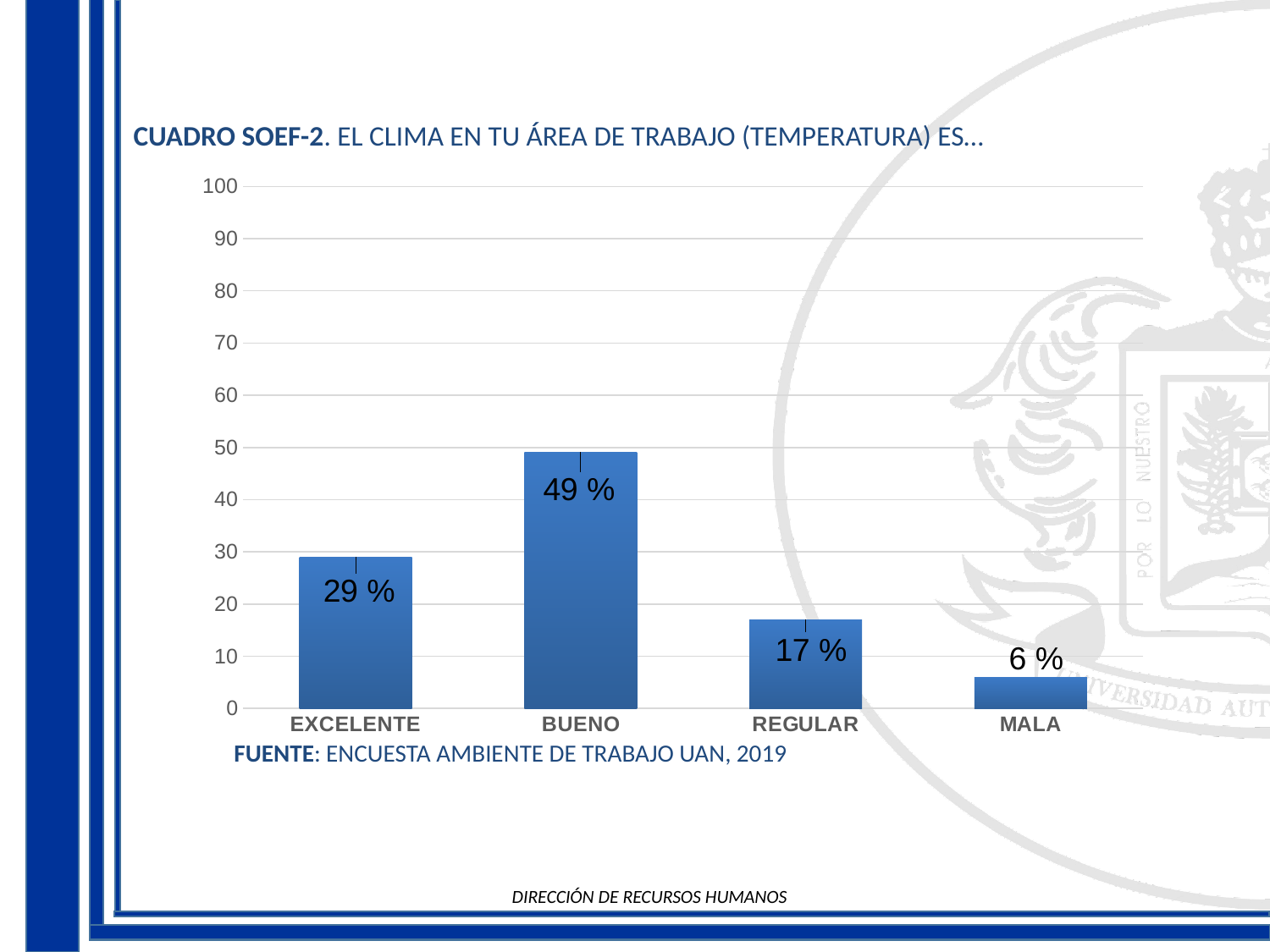
Is the value for BUENO greater or less than 40? greater What is the value for BUENO? 49 % Which category has the lowest value? MALA What is the value for EXCELENTE? 29 % Which is larger, the value for EXCELENTE or the value for REGULAR? EXCELENTE What kind of chart is shown on the slide? bar chart What is the difference between the values for BUENO and EXCELENTE? 20 % Which category has the highest value? BUENO What is the difference between the values for REGULAR and MALA? 11 % What is the value for MALA? 6 % What is the value for REGULAR? 17 % How many categories are shown on the x axis? 4